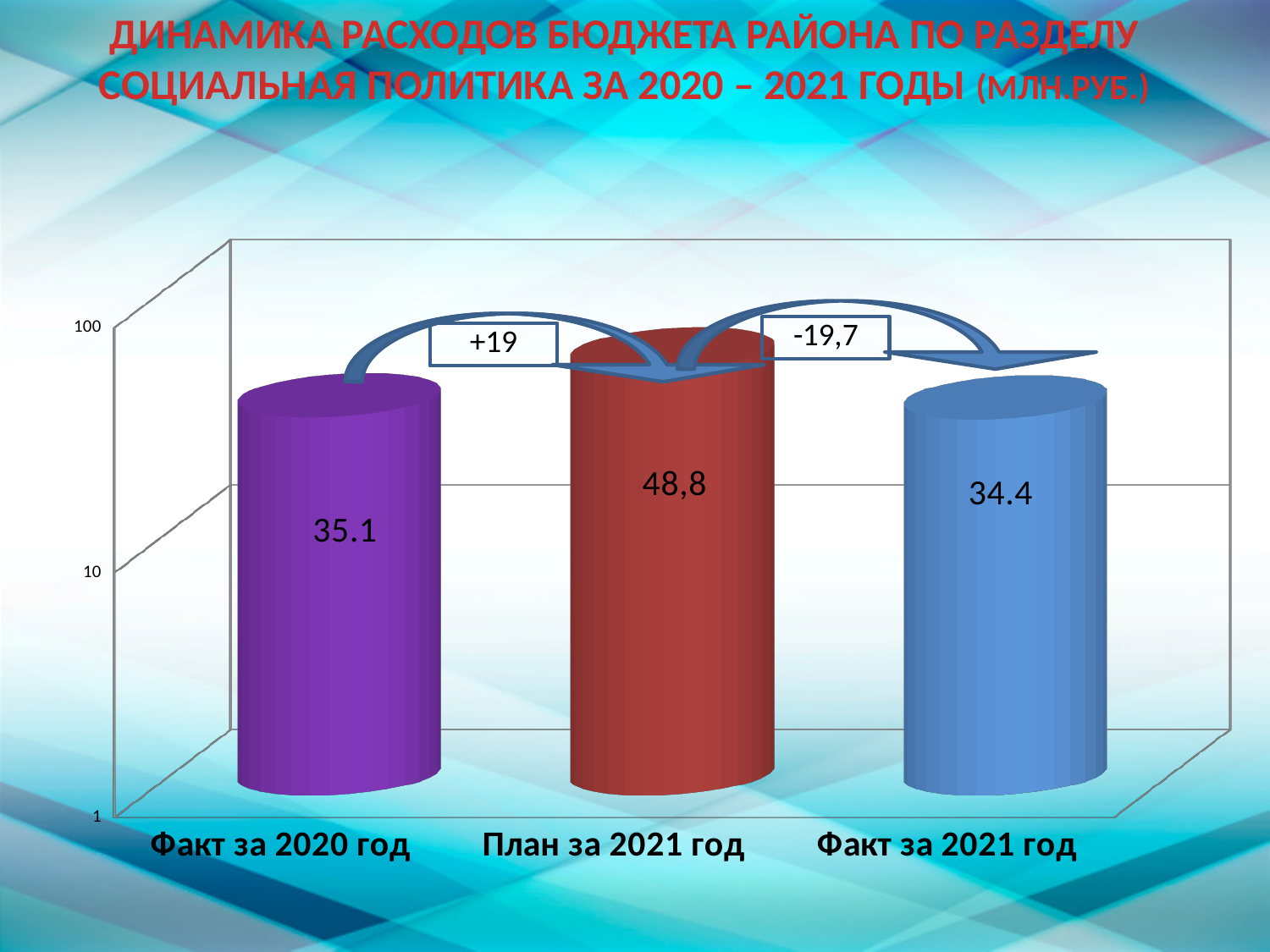
Which is larger, the value for Факт за 2020 год or the value for Факт за 2021 год? Факт за 2020 год What is the value for План за 2021 год? 48,8 What kind of chart is shown on the slide? bar chart What is the difference between the values for План за 2021 год and Факт за 2021 год? 14.4 What is the value for Факт за 2020 год? 35.1 What change is shown in the annotation between План за 2021 год and Факт за 2021 год? -19,7 Which category has the lowest value? Факт за 2021 год Is the value for Факт за 2021 год greater or less than 10? greater How many categories are shown on the x axis? 3 What is the value for Факт за 2021 год? 34.4 Which category has the highest value? План за 2021 год What is the difference between the values for План за 2021 год and Факт за 2020 год? 13.7